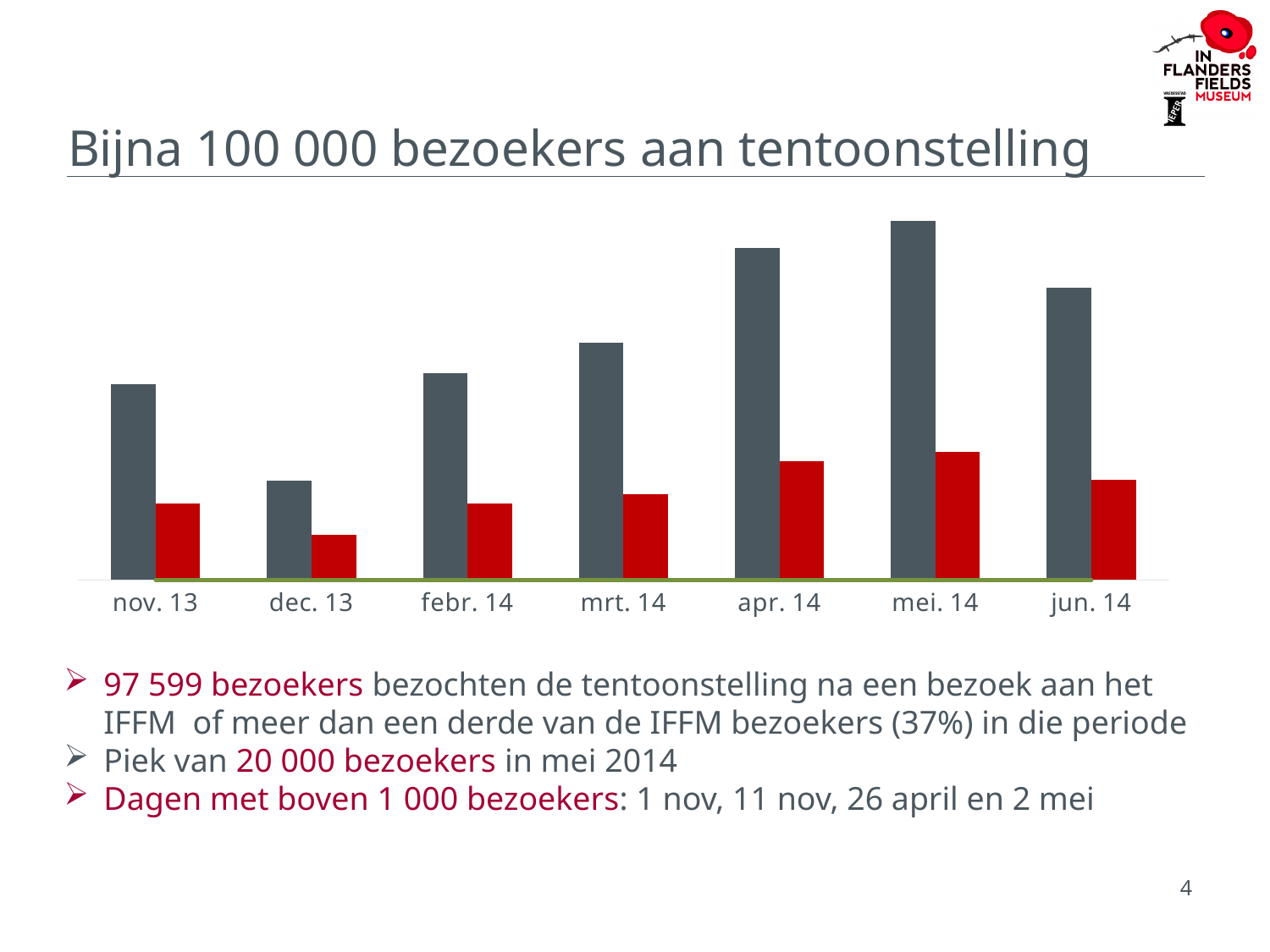
Which month has the shortest grey bar in the chart? dec. 13 How many bars are shown for each month in the chart? 2 Which month has the tallest grey bar in the chart? mei. 14 Is the red bar for nov. 13 taller or shorter than the red bar for mrt. 14? shorter In each month, which bar is taller, the grey one or the red one? the grey one Do the grey bars rise or fall from dec. 13 to mei. 14? rise How many months are shown on the x axis of the chart? 7 What colours are the two bar series in the chart? grey and red What kind of chart is shown on the slide? bar chart Is the grey bar for apr. 14 taller or shorter than the grey bar for jun. 14? taller Which month has the tallest red bar in the chart? mei. 14 Which month has the shortest red bar in the chart? dec. 13